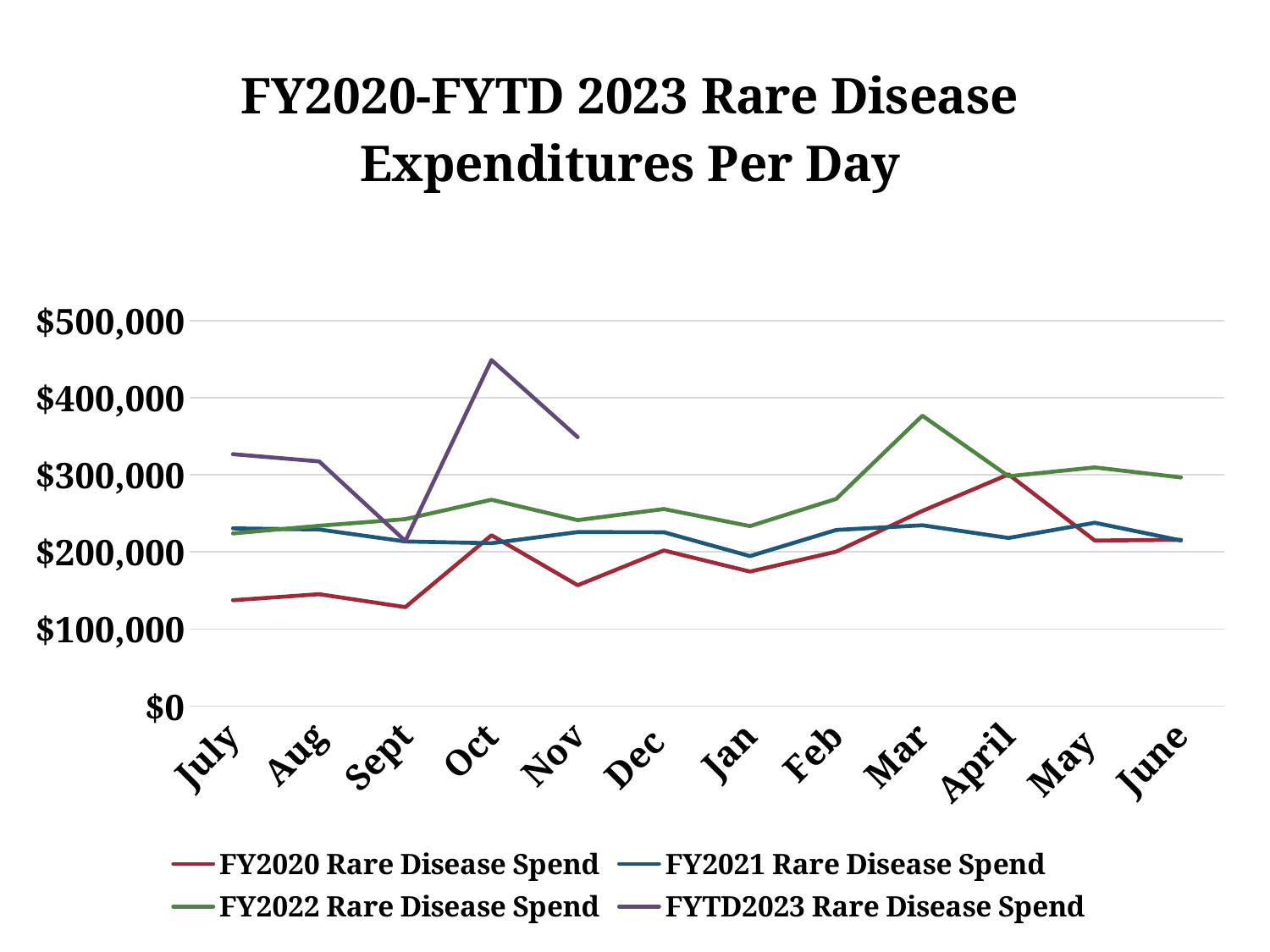
Is the FY2020 Rare Disease Spend value for July greater or less than $200,000? less What is the title of the chart? FY2020-FYTD 2023 Rare Disease Expenditures Per Day In which month does the FY2022 Rare Disease Spend series reach its highest value? Mar What kind of chart is shown on the slide? Line chart How many series does the legend list? 4 Is the FYTD2023 Rare Disease Spend value for Oct greater or less than $400,000? greater In which month does the FYTD2023 Rare Disease Spend series reach its highest value? Oct In Mar, which series is higher: FY2022 Rare Disease Spend or FY2020 Rare Disease Spend? FY2022 Rare Disease Spend In which month is the FY2020 Rare Disease Spend series at its lowest? Sept How many months have a plotted value for the FYTD2023 Rare Disease Spend series? 5 How many months are shown along the x axis? 12 Between Oct and Nov, does the FYTD2023 Rare Disease Spend series rise or fall? fall